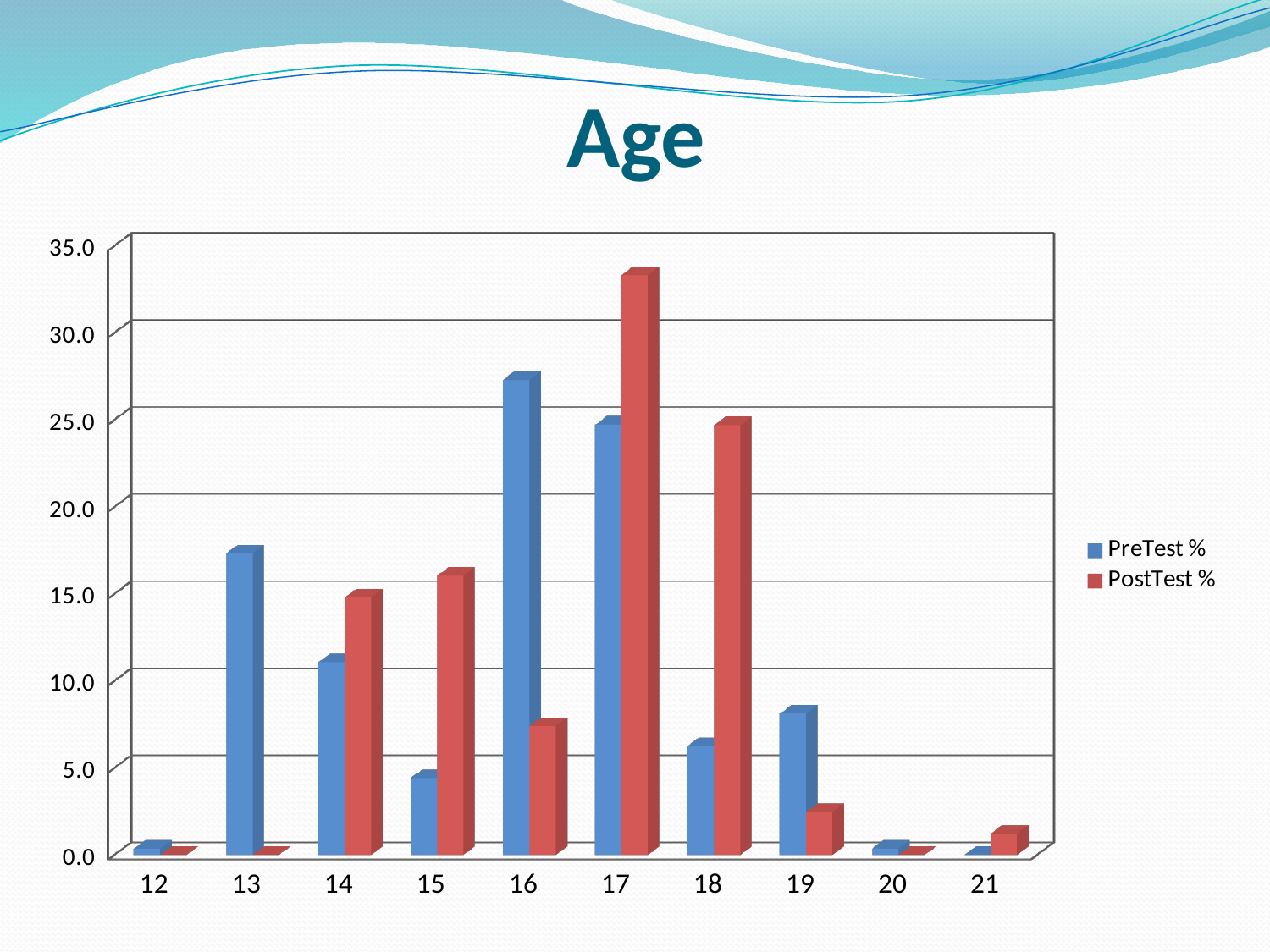
Is the PreTest % value for age 13 greater or less than 15.0? greater Is the PostTest % value for age 19 greater or less than 5.0? less For age 18, which series has the larger value, PreTest % or PostTest %? PostTest % Is the PostTest % value for age 17 greater or less than 30.0? greater For age 16, which series has the larger value, PreTest % or PostTest %? PreTest % How many series does the legend list? 2 How many age categories are shown on the x axis? 10 Which age has the highest PreTest % value? 16 Which age has the highest PostTest % value? 17 What kind of chart is shown on the slide? bar chart What is the title of the chart? Age